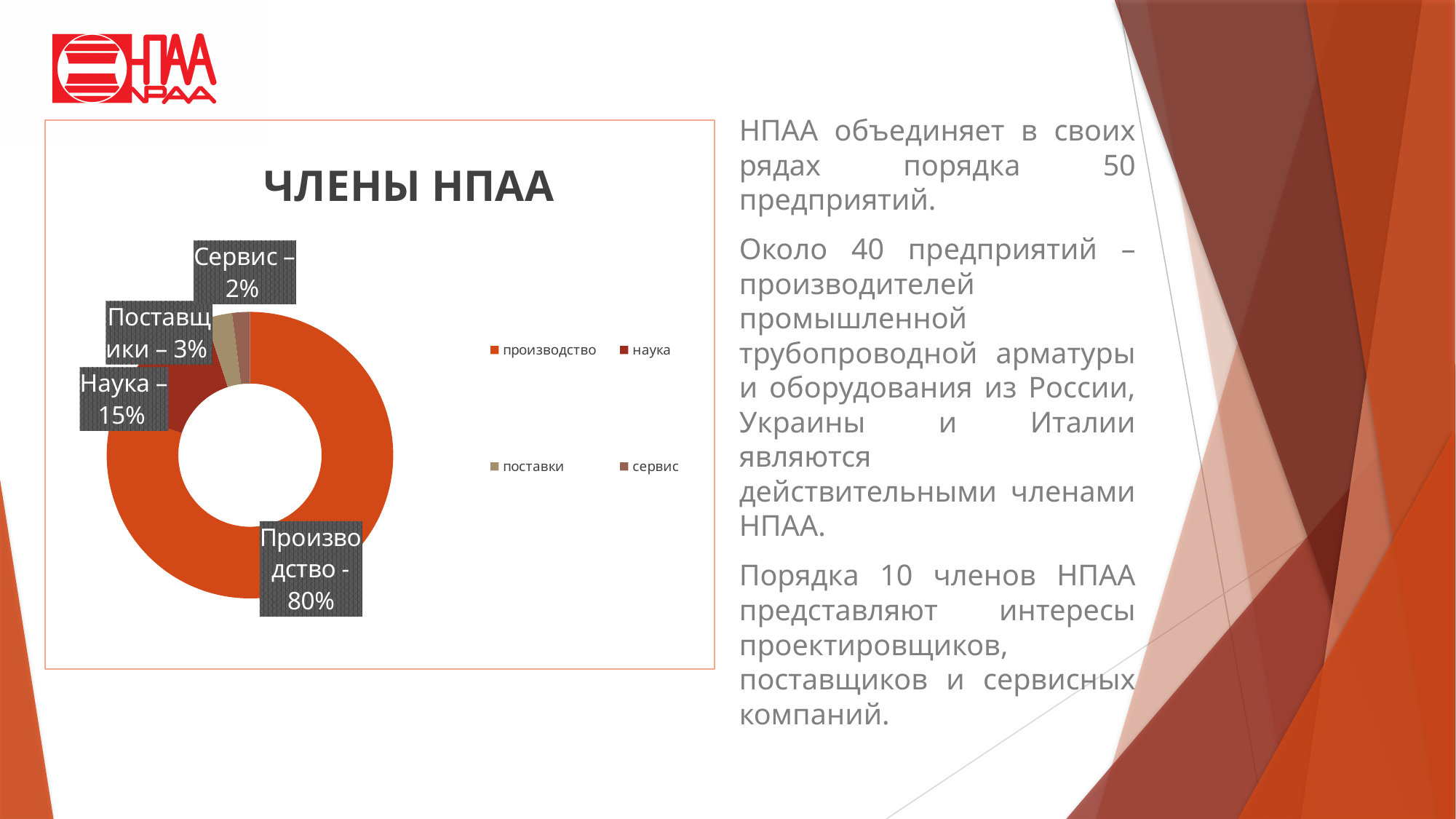
What is the difference in percentage points between Наука and Поставщики? 12 What share of the chart does Поставщики account for? 3% What kind of chart is shown on the slide? doughnut chart What is the difference in percentage points between Производство and Наука? 65 What share of the chart does Сервис account for? 2% What share of the chart does Наука account for? 15% Which category has the smallest share of the chart? Сервис Which category has the largest share of the chart? Производство Which is larger, the share for Наука or the share for Сервис? Наука What share of the chart does Производство account for? 80% How many categories are shown in the chart? 4 What is the title of the chart? ЧЛЕНЫ НПАА